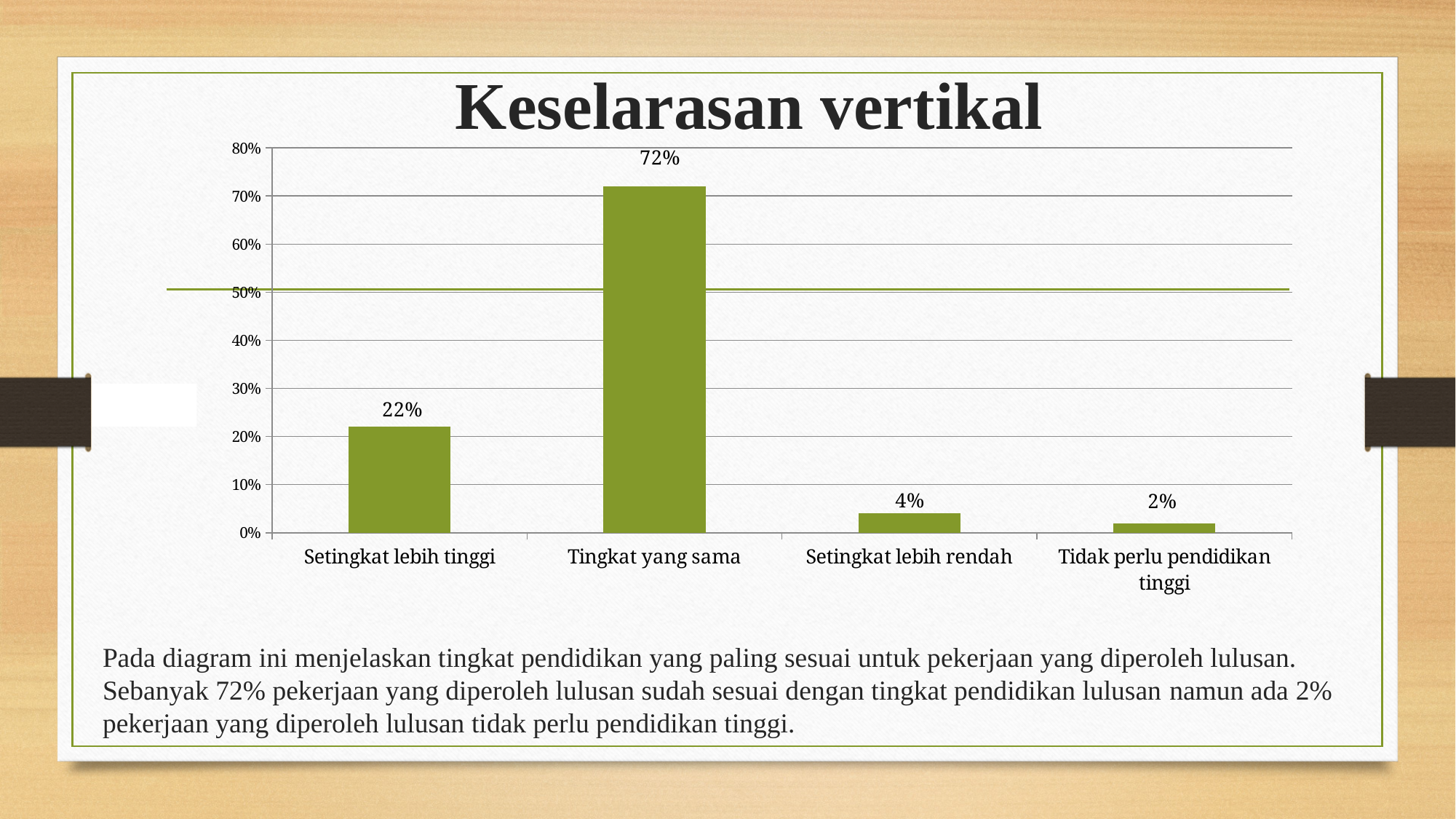
Is the value for Tingkat yang sama greater or less than 50%? greater What is the value for Tingkat yang sama? 72% What kind of chart is shown on the slide? bar chart What is the difference between the values for Setingkat lebih rendah and Tidak perlu pendidikan tinggi? 2% Which category has the lowest value? Tidak perlu pendidikan tinggi Which category has the highest value? Tingkat yang sama What is the value for Setingkat lebih tinggi? 22% How many categories are shown on the x axis? 4 What is the value for Tidak perlu pendidikan tinggi? 2% Which is larger, the value for Setingkat lebih tinggi or the value for Setingkat lebih rendah? Setingkat lebih tinggi What is the difference between the values for Tingkat yang sama and Setingkat lebih tinggi? 50% What is the value for Setingkat lebih rendah? 4%